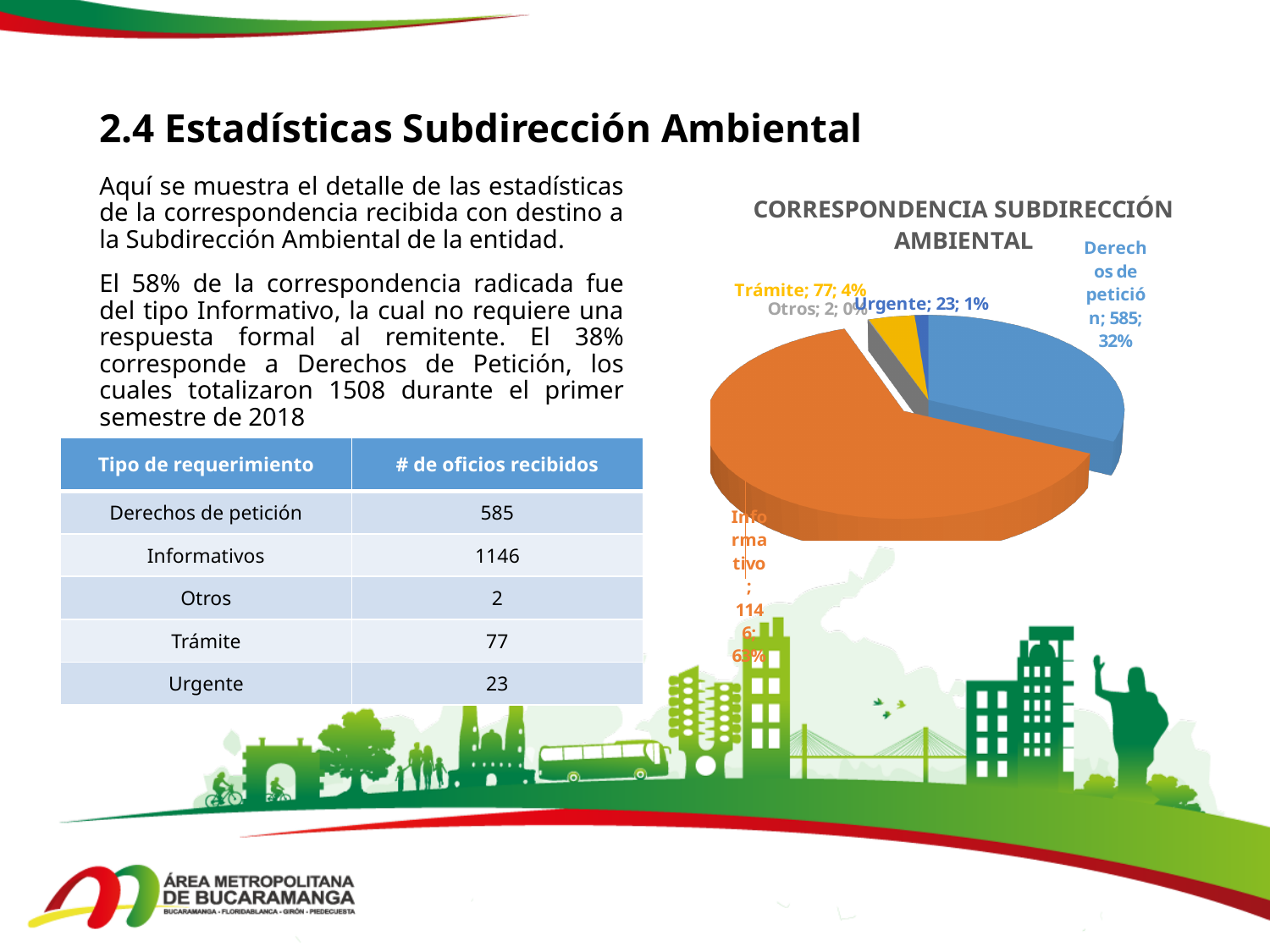
What is the value shown for Urgente in the pie chart? 23 What percentage share does Trámite have in the pie chart? 4% Which category has the largest slice in the pie chart? Informativo What is the title of the chart? CORRESPONDENCIA SUBDIRECCIÓN AMBIENTAL What percentage share does Derechos de petición have in the pie chart? 32% What is the difference between the values for Derechos de petición and Trámite in the pie chart? 508 Which category has the smallest slice in the pie chart? Otros What kind of chart is shown on the slide? pie chart What is the value shown for Otros in the pie chart? 2 How many slices does the pie chart have? 5 What is the value shown for Trámite in the pie chart? 77 What is the value shown for Derechos de petición in the pie chart? 585